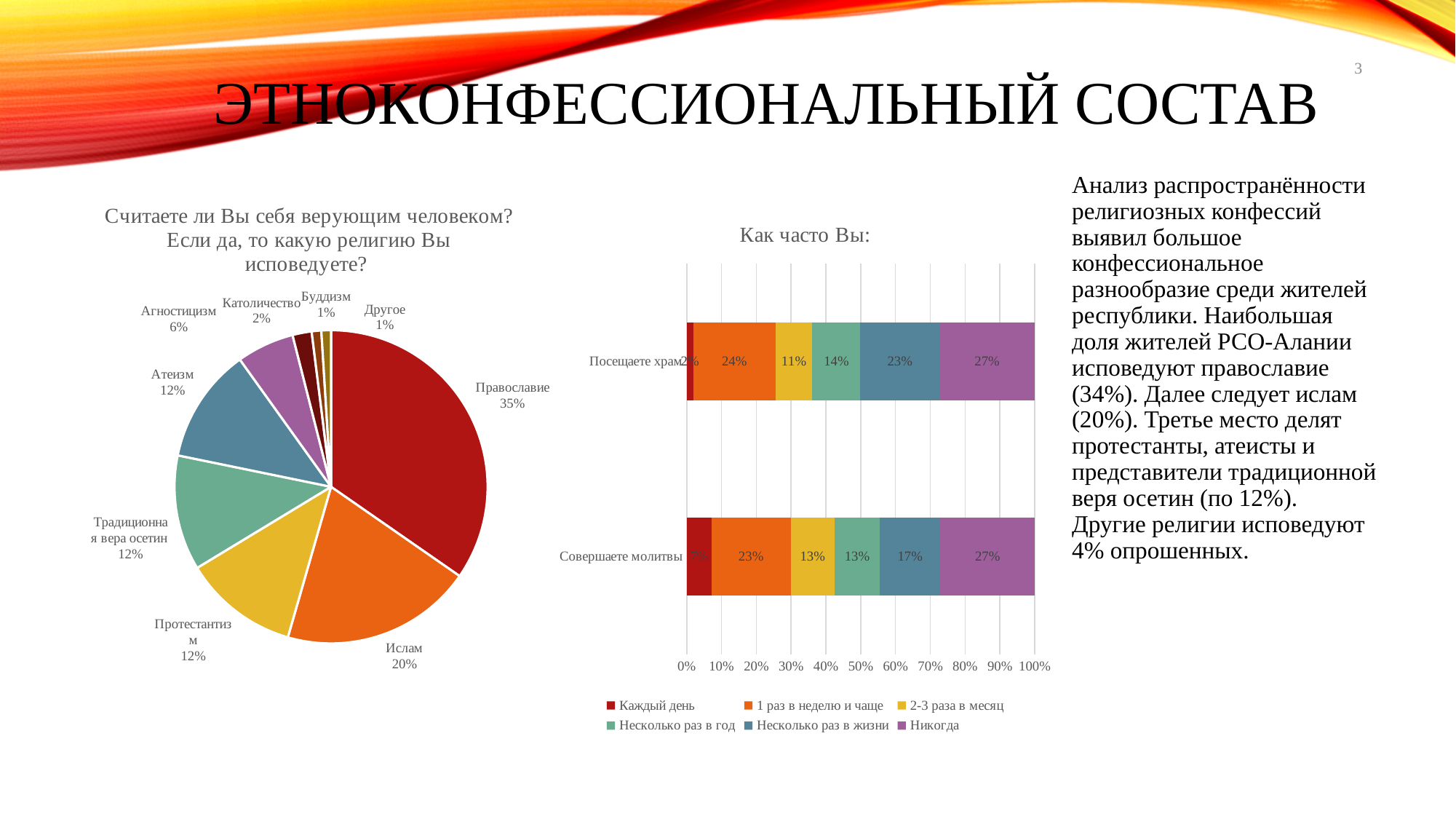
In the pie chart on the left, what share of respondents is shown for Православие? 35% In the chart titled 'Как часто Вы:', what is the value for 'Никогда' in the 'Посещаете храм' bar? 27% What type of chart is the chart on the left titled 'Считаете ли Вы себя верующим человеком?'? Pie chart In the pie chart on the left, which category has the largest slice? Православие In the pie chart on the left, what percentage is shown for Ислам? 20% In the chart titled 'Как часто Вы:', what is the value for 'Каждый день' in the 'Совершаете молитвы' bar? 7% What type of chart is the chart titled 'Как часто Вы:'? Stacked bar chart In the chart titled 'Как часто Вы:', how many series does the legend list? 6 In the chart titled 'Как часто Вы:', how many bars (categories) are shown? 2 In the pie chart on the left, how many categories (slices) are labelled? 9 In the chart titled 'Как часто Вы:', which bar has the larger value for 'Несколько раз в жизни': 'Посещаете храм' or 'Совершаете молитвы'? Посещаете храм In the pie chart on the left, what is the difference in percentage points between Православие and Ислам? 15 percentage points